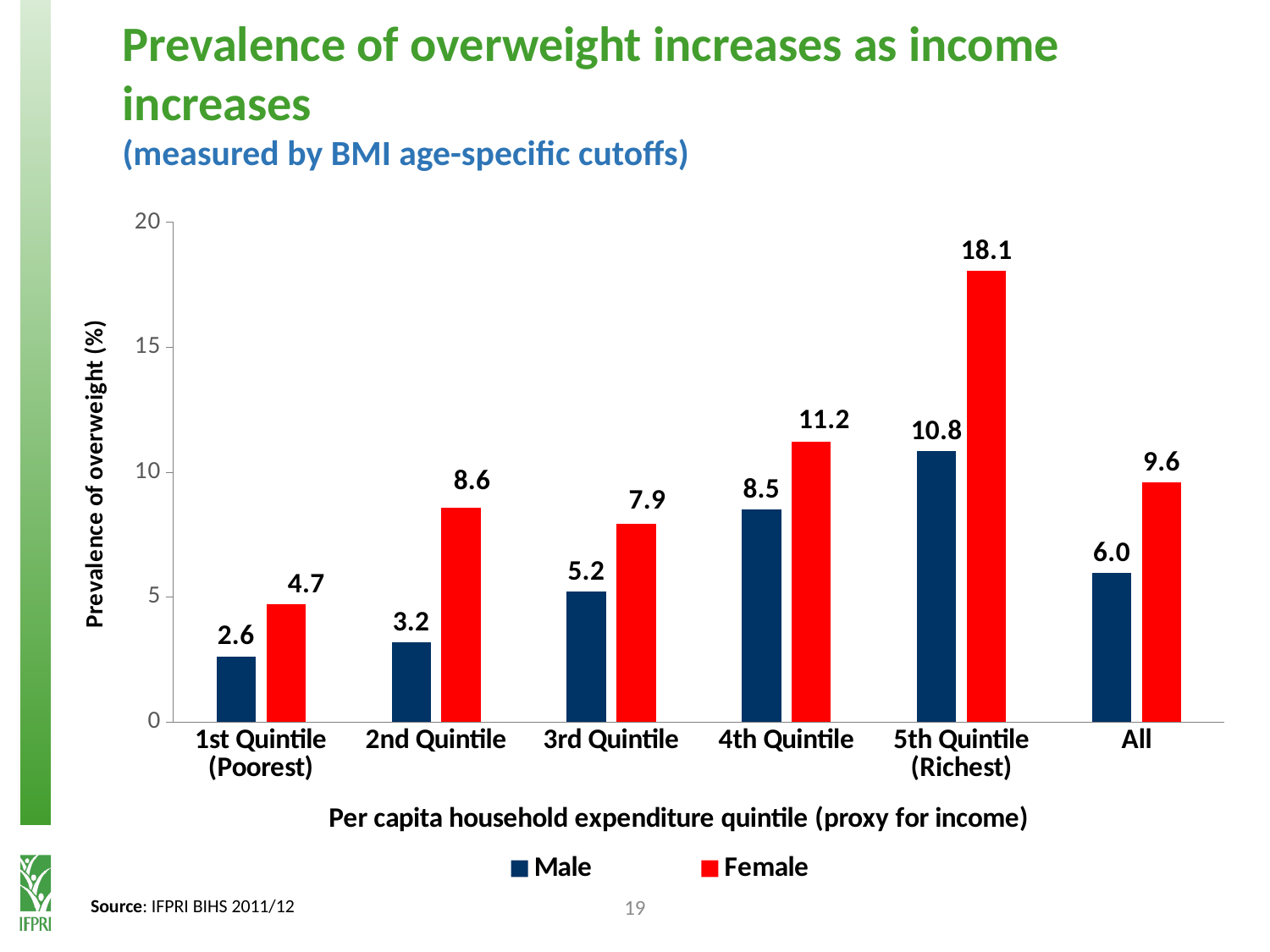
What is the difference between the Female and Male values for the 5th Quintile (Richest)? 7.3 What is the Male value for the All category? 6.0 What kind of chart is shown on the slide? Bar chart Which category has the lowest Male value? 1st Quintile (Poorest) Do the Male values rise or fall from the 1st Quintile to the 5th Quintile? Rise What is the label of the y axis? Prevalence of overweight (%) What is the Female value for the 5th Quintile (Richest)? 18.1 Which category has the highest Female value? 5th Quintile (Richest) How many series does the legend list? 2 How many categories are shown on the x axis? 6 What is the Male value for the 1st Quintile (Poorest)? 2.6 Which is larger for the 3rd Quintile, the Male value or the Female value? Female